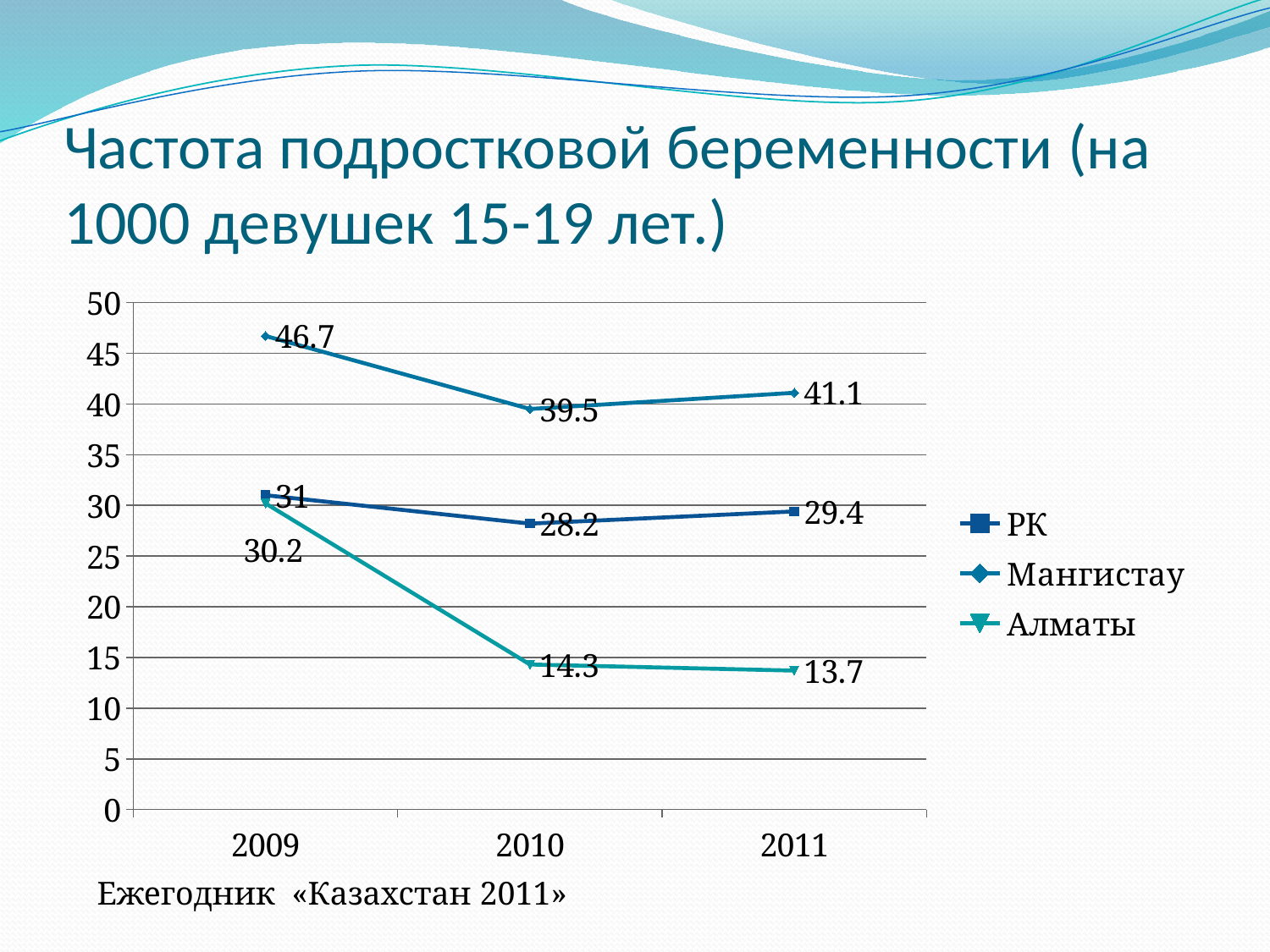
What is the value for РК in 2011? 29.4 What kind of chart is shown on the slide? line chart What is the value for Мангистау in 2009? 46.7 Which series has the highest value in 2011? Мангистау Which series has the lowest value in 2010? Алматы How many years are shown on the x axis? 3 What is the difference between the Мангистау value in 2009 and in 2010? 7.2 Does the Алматы series rise or fall from 2009 to 2011? fall Is the value for Алматы in 2011 greater or less than 15? less What is the value for Алматы in 2010? 14.3 How many series does the legend list? 3 Which is larger, the РК value in 2009 or the Алматы value in 2009? РК